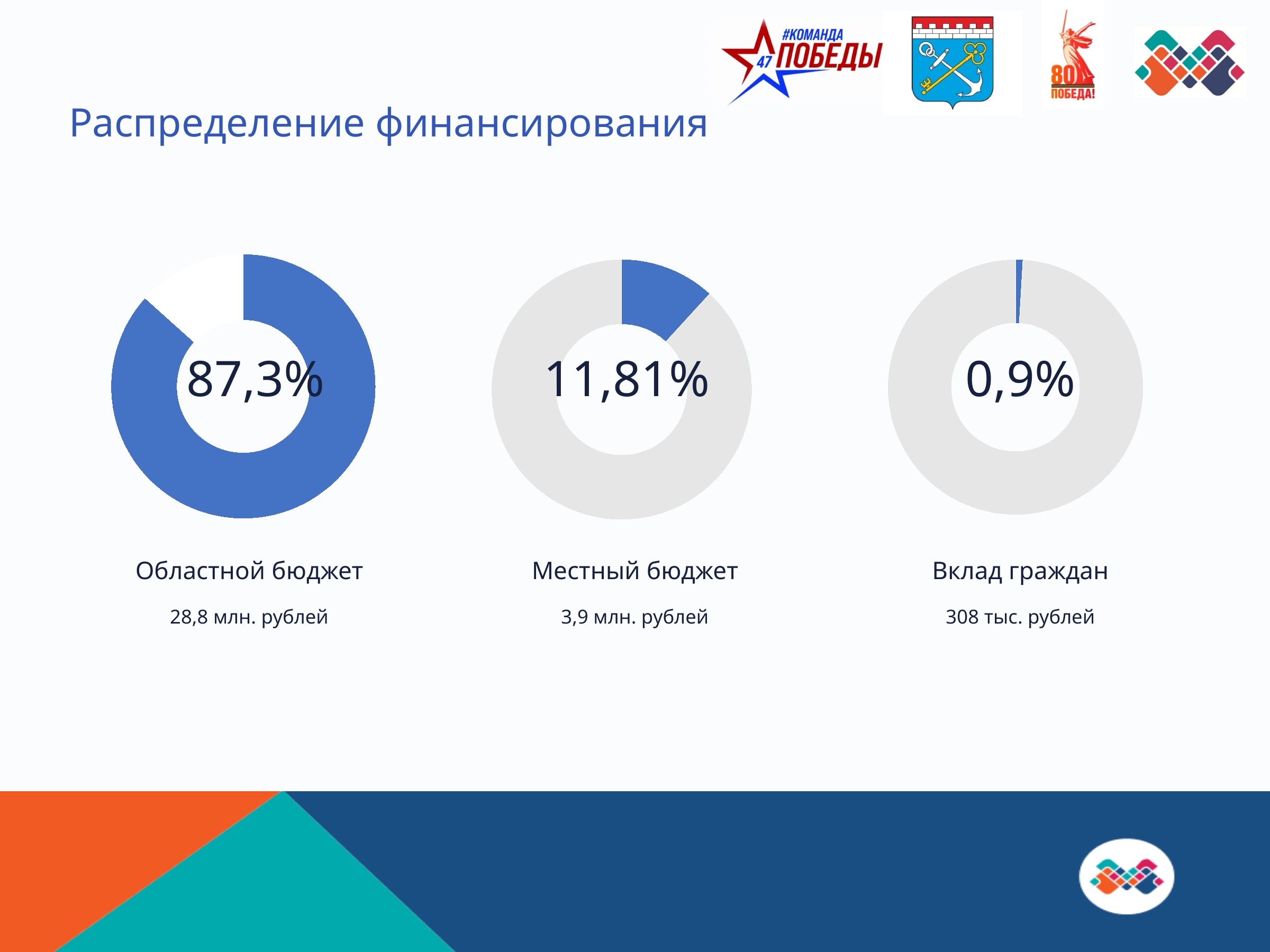
How many donut charts are shown on the slide? 3 Which share is larger: Местный бюджет or Вклад граждан? Местный бюджет In the middle donut chart (Местный бюджет), what percentage is shown? 11,81% Which funding source has the highest share across the three donut charts? Областной бюджет In the left donut chart (Областной бюджет), what percentage is shown? 87,3% What is the title of the slide containing the three donut charts? Распределение финансирования What amount in rubles is given under the Местный бюджет chart? 3,9 млн. рублей What is the difference in percentage points between the Областной бюджет share and the Местный бюджет share? 75,49% Which funding source has the lowest share across the three donut charts? Вклад граждан What amount in rubles is given under the Вклад граждан chart? 308 тыс. рублей What amount in rubles is given under the Областной бюджет chart? 28,8 млн. рублей In the right donut chart (Вклад граждан), what percentage is shown? 0,9%